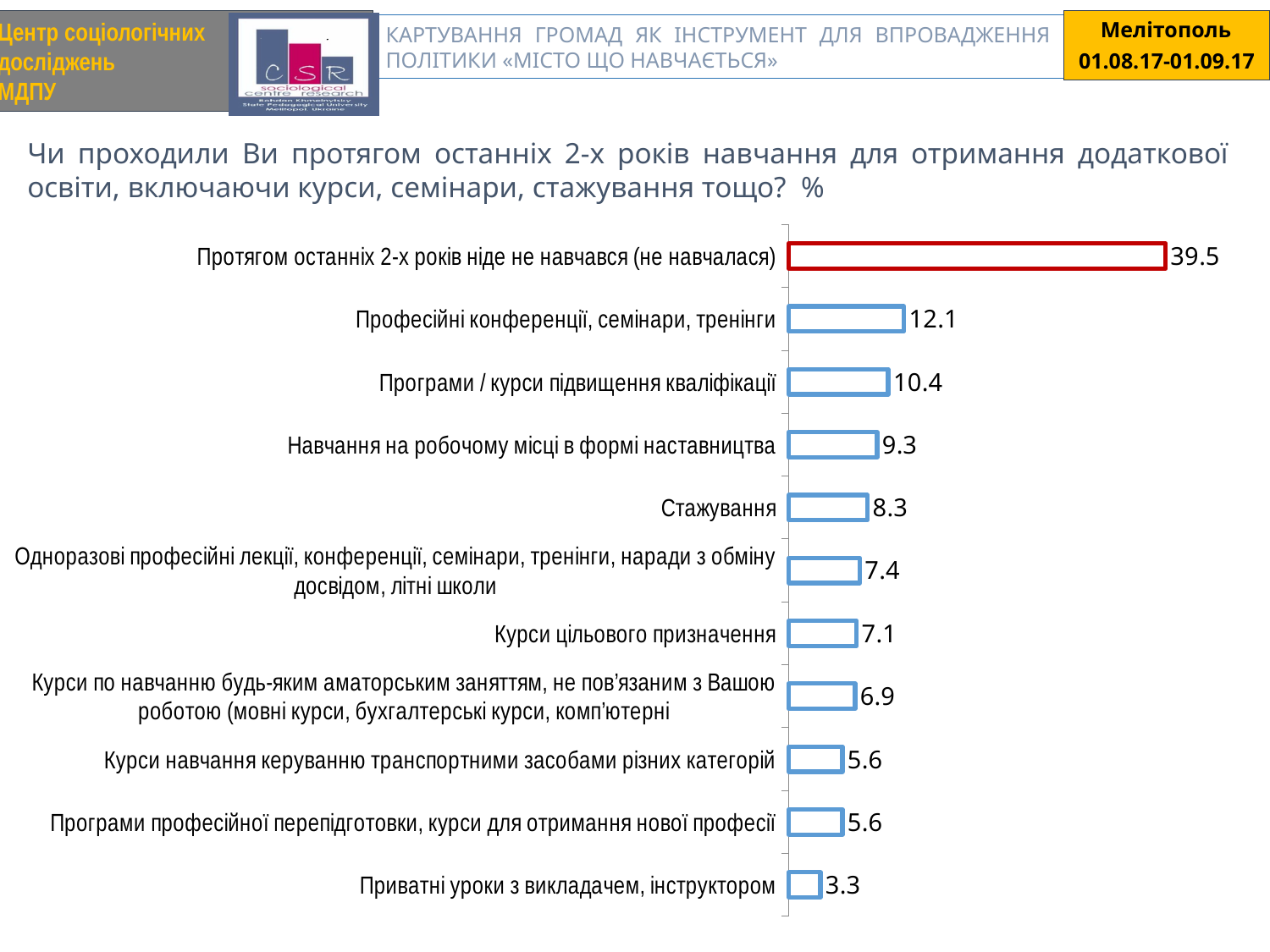
What value is shown for «Курси цільового призначення»? 7.1 Which category has the lowest value? Приватні уроки з викладачем, інструктором What is the difference between the value for «Протягом останніх 2-х років ніде не навчався (не навчалася)» and the value for «Професійні конференції, семінари, тренінги»? 27.4 What value is shown for «Стажування»? 8.3 How many categories are shown in the chart? 11 What value is shown for «Приватні уроки з викладачем, інструктором»? 3.3 What is the difference between the value for «Навчання на робочому місці в формі наставництва» and the value for «Стажування»? 1.0 What value is shown for «Професійні конференції, семінари, тренінги»? 12.1 What kind of chart is shown on the slide? Bar chart Which bar is outlined in a different colour (red) from the others? Протягом останніх 2-х років ніде не навчався (не навчалася) Which category has the highest value? Протягом останніх 2-х років ніде не навчався (не навчалася) Which is larger: the value for «Програми / курси підвищення кваліфікації» or the value for «Навчання на робочому місці в формі наставництва»? Програми / курси підвищення кваліфікації